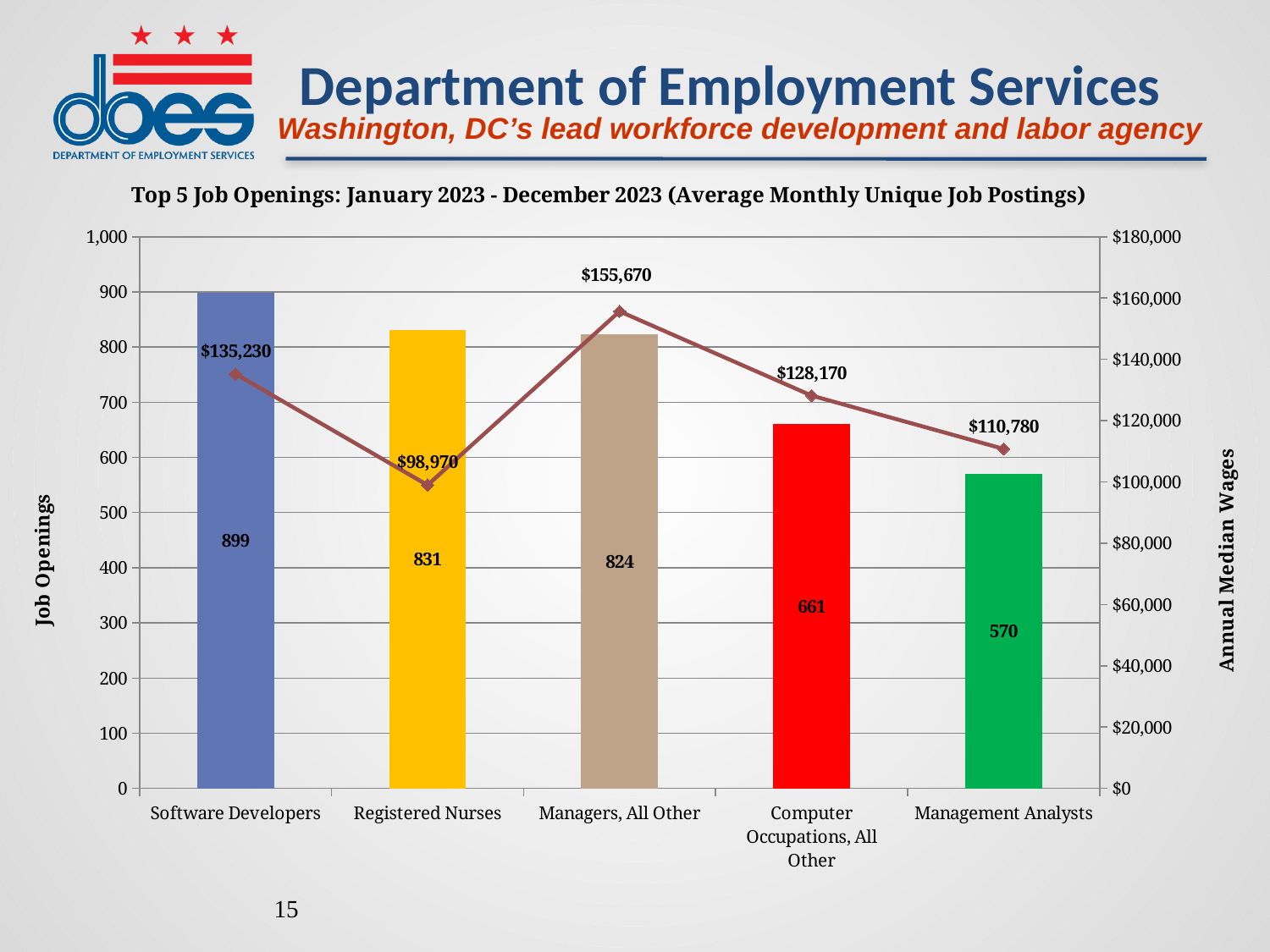
Do the job openings rise or fall from left to right across the occupations? Fall How many job openings are shown for Management Analysts? 570 Which occupation has the lowest annual median wage? Registered Nurses What is the difference in job openings between Software Developers and Management Analysts? 329 Which has more job openings, Registered Nurses or Computer Occupations, All Other? Registered Nurses How many job openings are shown for Software Developers? 899 What kind of chart is used to show job openings? Bar chart How many occupations are shown on the x axis? 5 What is the annual median wage shown for Registered Nurses? $98,970 What is the label of the right-hand vertical axis? Annual Median Wages What is the annual median wage shown for Managers, All Other? $155,670 Which occupation has the highest number of job openings? Software Developers